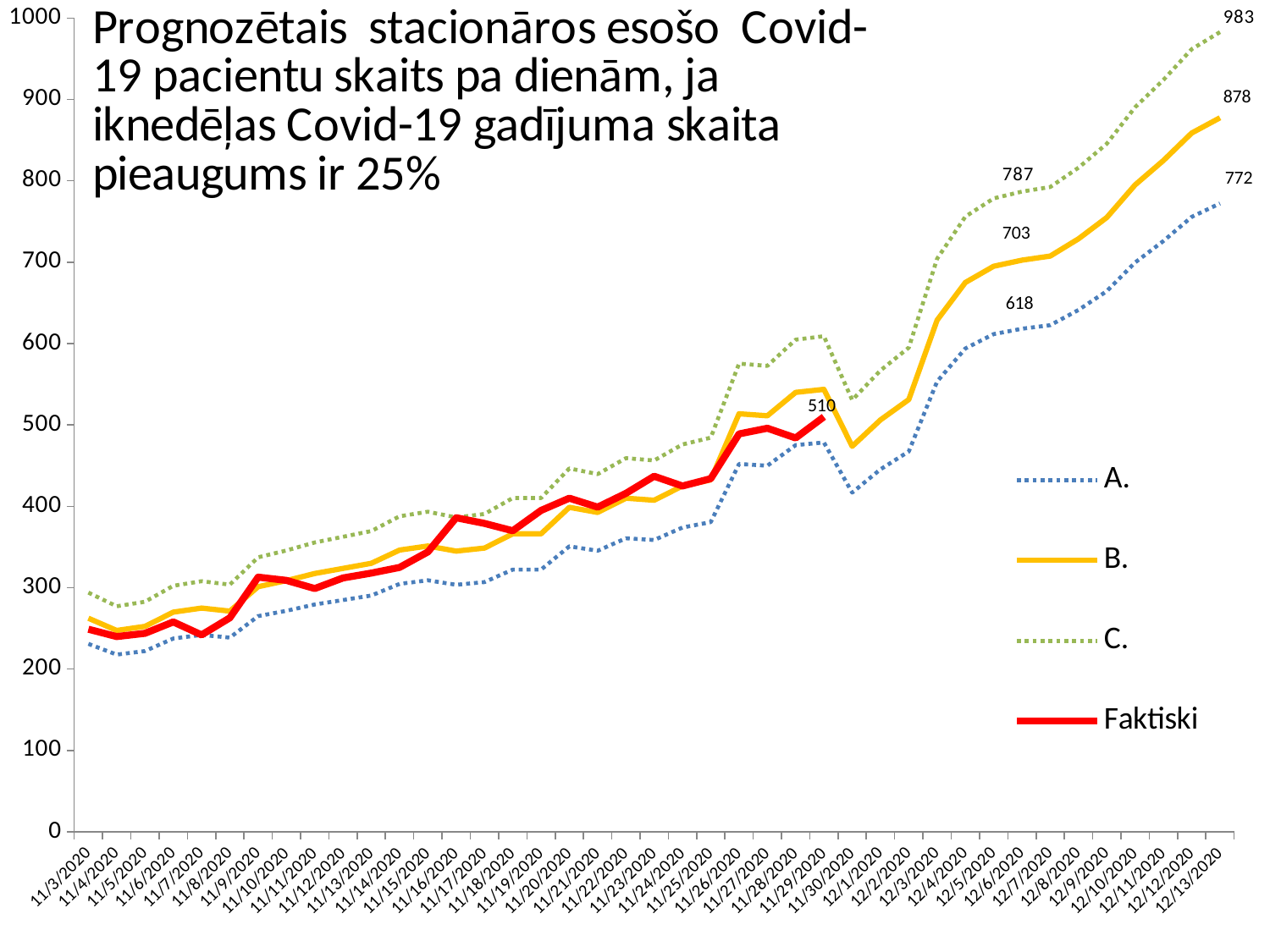
Is the Faktiski value at 11/3/2020 greater or less than 300? less What is the last labelled value of the Faktiski series? 510 What is the value of series B. at 12/13/2020? 878 What is the value of series A. at 12/13/2020? 772 How many series does the legend list? 4 Which is larger at 12/13/2020, series B. or series A.? B. Which series has the highest value at 12/13/2020? C. What is the value of series C. at 12/13/2020? 983 What is the difference between series C. and series A. at 12/13/2020? 211 Does series A. generally rise or fall from 11/3/2020 to 12/13/2020? rise What is the difference between series B. and series A. at 12/13/2020? 106 What kind of chart is shown on the slide? line chart